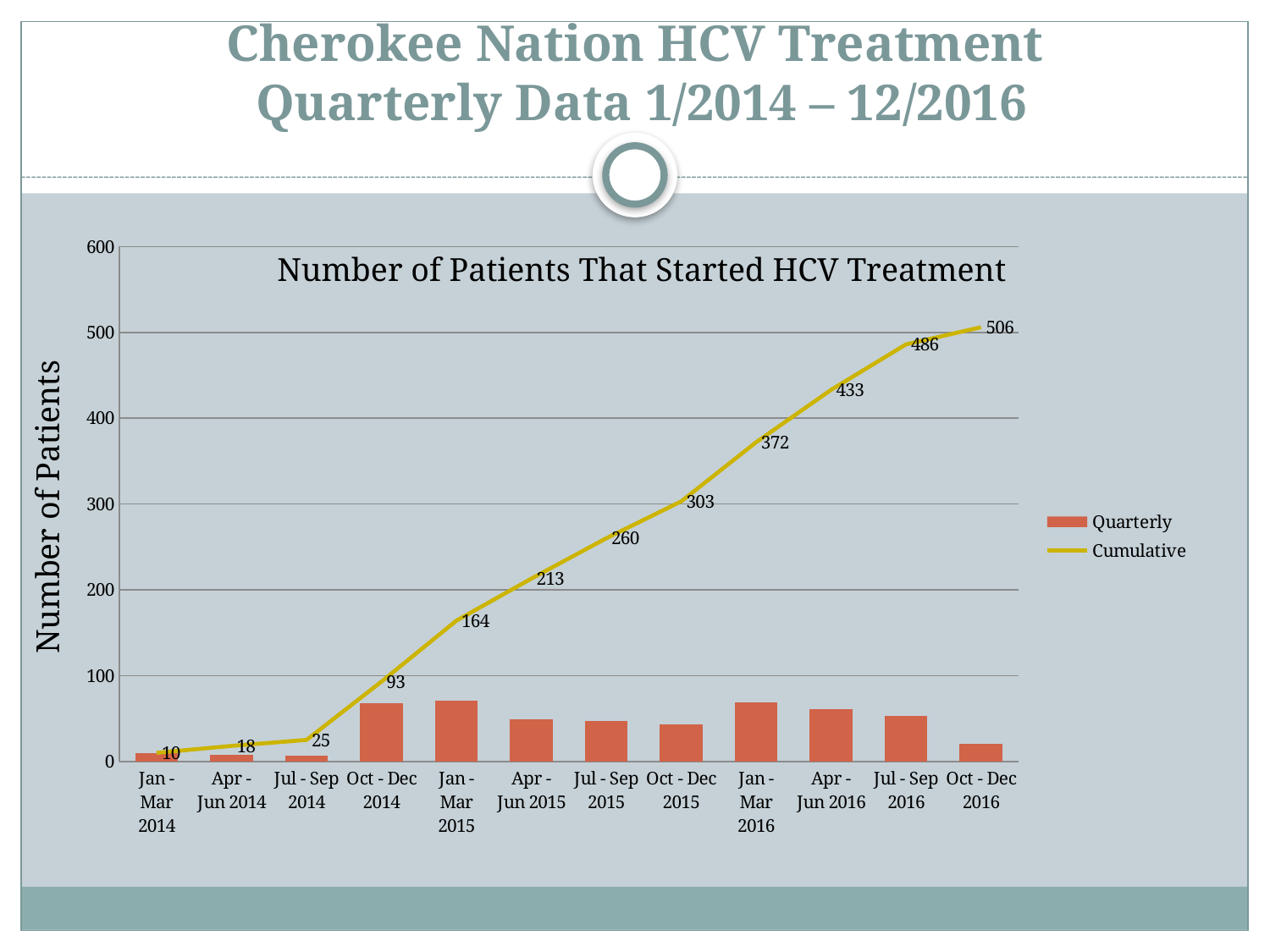
What is the cumulative value shown for Jan - Mar 2015? 164 How many quarters are shown on the x axis? 12 How many series does the legend list? 2 Which quarter has the lowest cumulative value? Jan - Mar 2014 Which quarter has the highest cumulative value? Oct - Dec 2016 Which is larger, the cumulative value for Apr - Jun 2016 or for Jan - Mar 2016? Apr - Jun 2016 Does the Cumulative line rise or fall from Jan - Mar 2014 to Oct - Dec 2016? rise What is the title of the chart? Number of Patients That Started HCV Treatment What is the cumulative value shown for Jul - Sep 2014? 25 What is the difference between the cumulative values for Oct - Dec 2015 and Jul - Sep 2015? 43 What is the cumulative number of patients at Oct - Dec 2016? 506 Is the Quarterly bar for Jan - Mar 2015 greater or less than 100? less